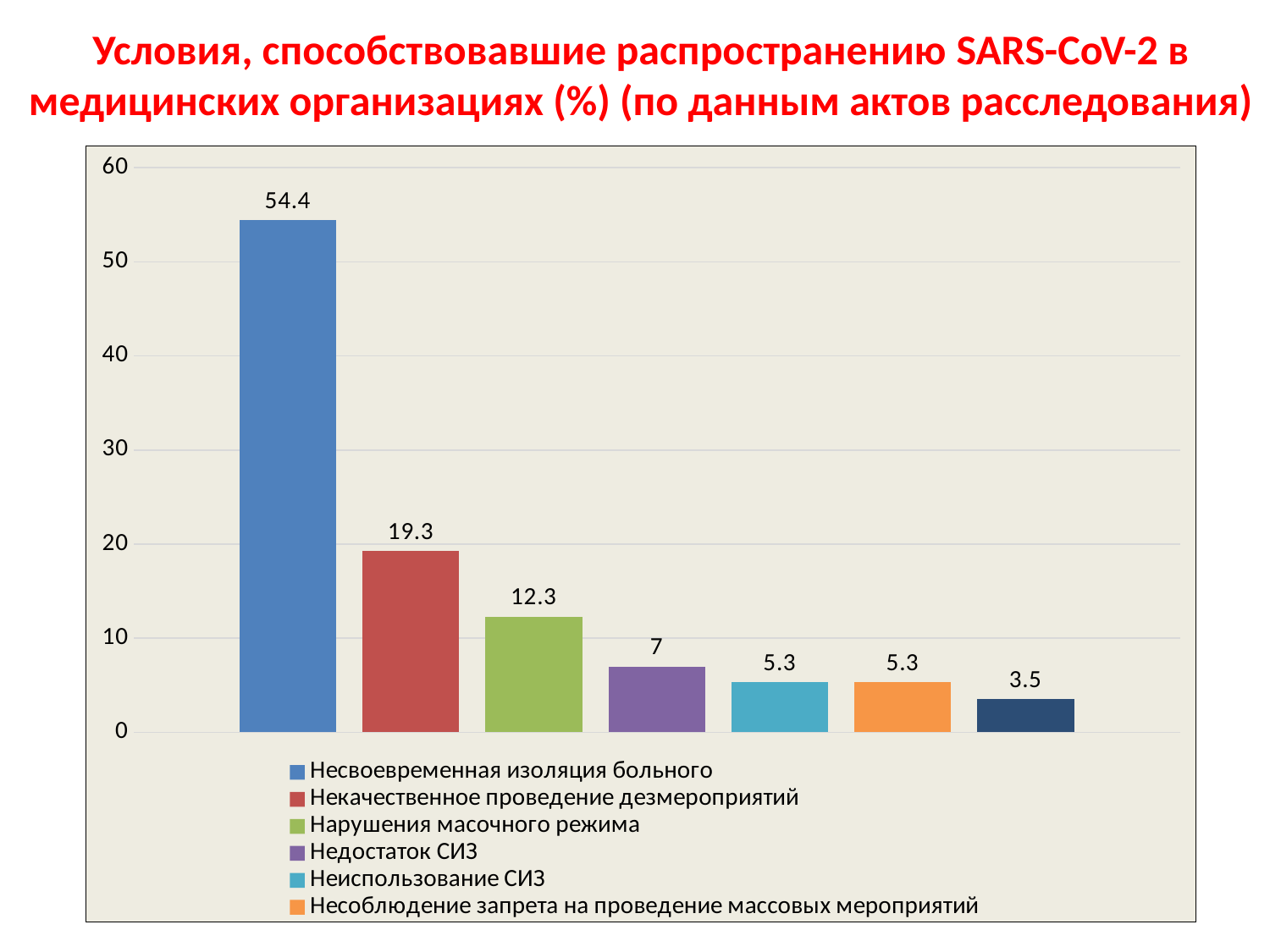
Is the value for Несвоевременная изоляция больного greater or less than 50? greater What kind of chart is shown on the slide? bar chart What is the value for Недостаток СИЗ? 7 How many entries does the legend list? 6 What is the difference between the values for Несвоевременная изоляция больного and Некачественное проведение дезмероприятий? 35.1 What is the value for Нарушения масочного режима? 12.3 How many bars are plotted in the chart? 7 What is the value for Несоблюдение запрета на проведение массовых мероприятий? 5.3 Which category has the highest value? Несвоевременная изоляция больного What is the value for Некачественное проведение дезмероприятий? 19.3 Which is larger: the value for Нарушения масочного режима or the value for Недостаток СИЗ? Нарушения масочного режима What is the value for Несвоевременная изоляция больного? 54.4